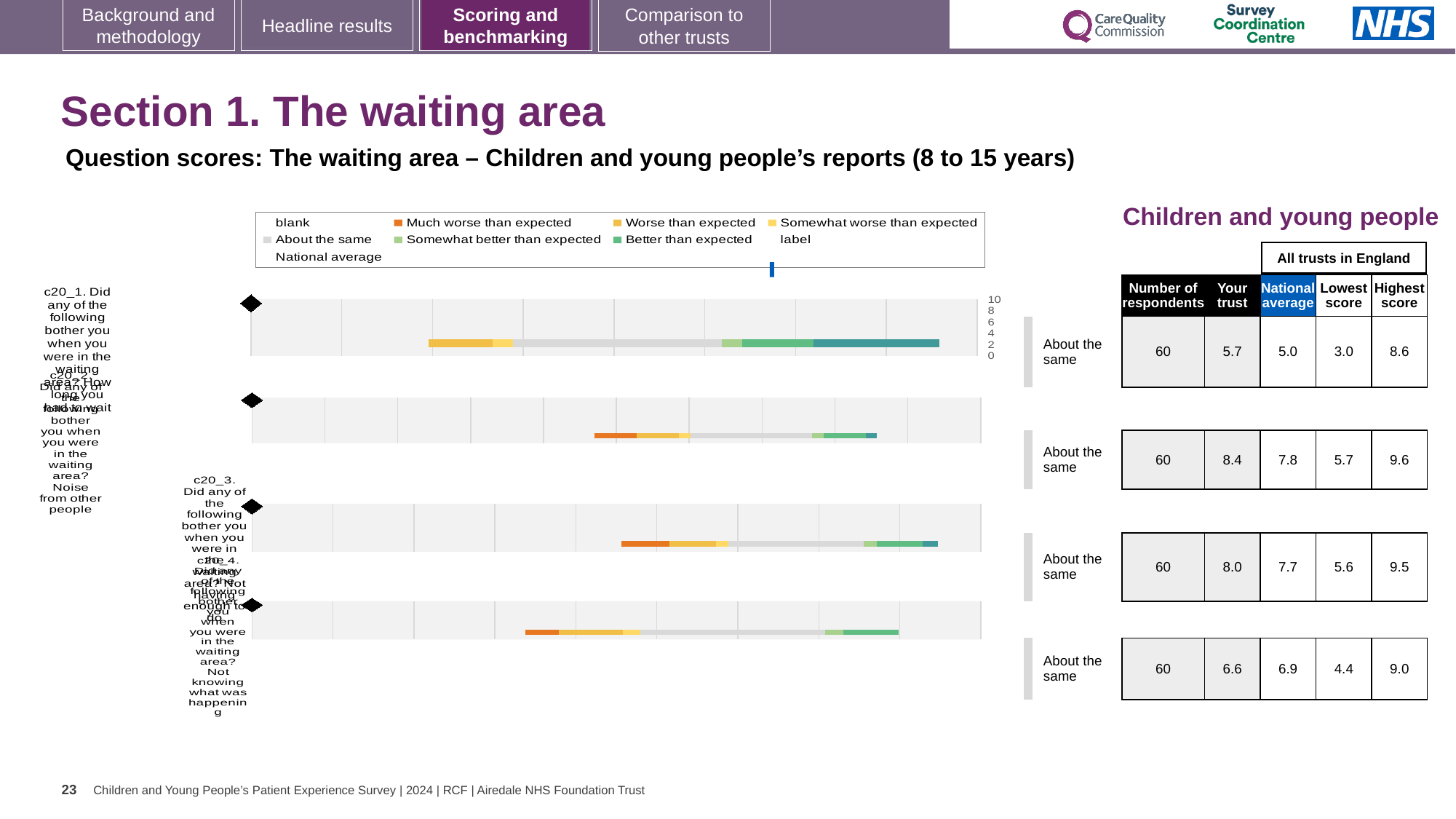
In the table beside the charts, which question has the lowest 'Your trust' score? c20_1 (How long you had to wait), 5.7 What kind of chart is used to show the question scores for the waiting area? Bar chart In the table beside the charts, how many respondents are listed for each question? 60 How many entries does the legend above the charts list? 9 What benchmark category is shown next to the bar for c20_1 (Did any of the following bother you when you were in the waiting area? How long you had to wait)? About the same Which legend entry is shown in grey? About the same How many question bars (c20_1 to c20_4) are plotted on the slide? 4 Which legend entry is shown in orange? Much worse than expected In the table beside the charts, which question has the highest 'Your trust' score? c20_2 (Noise from other people), 8.4 In the table beside the charts, what is the 'Your trust' score for c20_1 (How long you had to wait)? 5.7